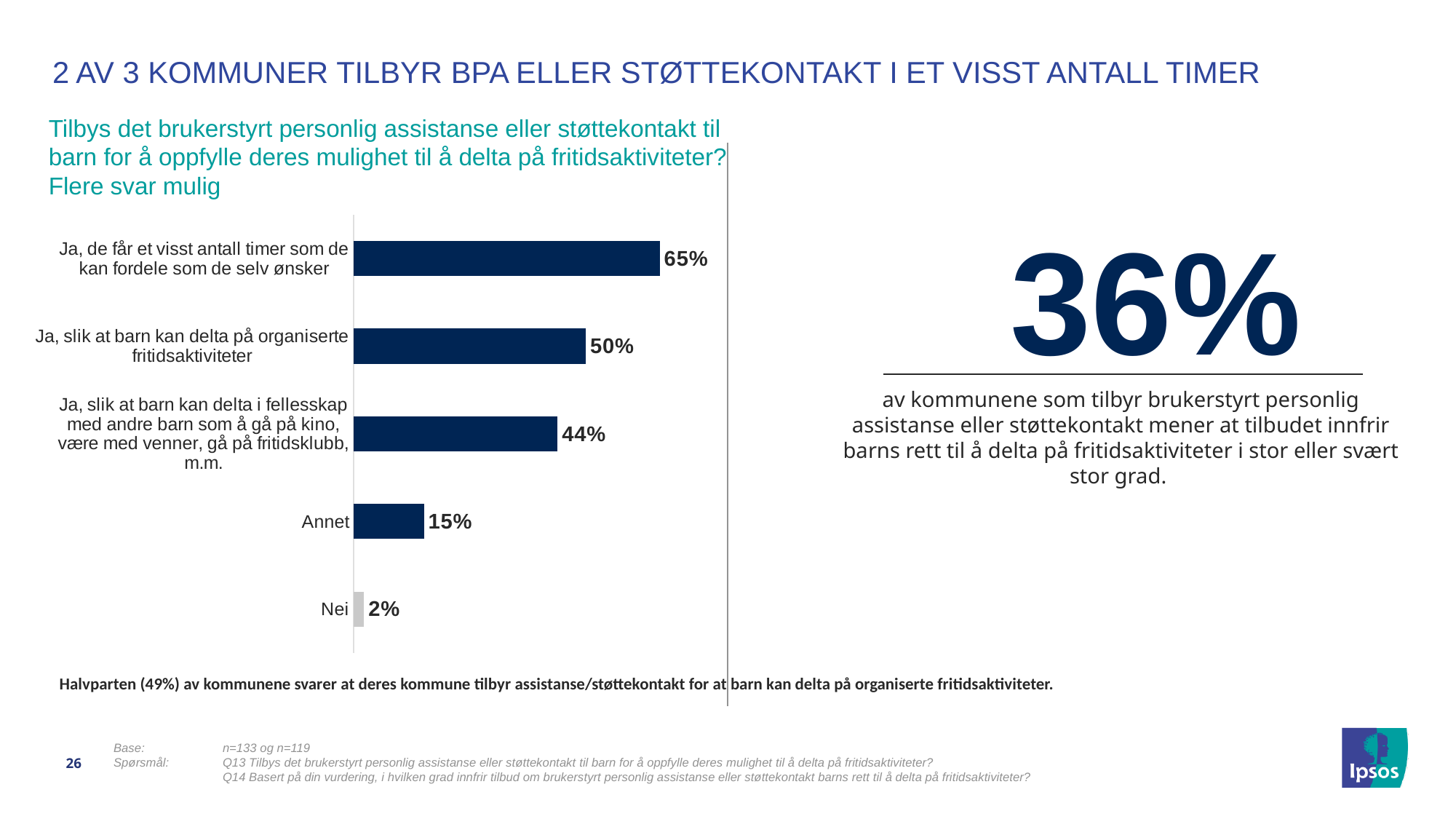
What is the value for "Nei"? 2% What is the value for "Annet"? 15% What is the value for "Ja, de får et visst antall timer som de kan fordele som de selv ønsker"? 65% What is the difference between the highest and lowest values in the chart? 63 percentage points Which category has the highest value? Ja, de får et visst antall timer som de kan fordele som de selv ønsker Which category has the lowest value? Nei What is the value for "Ja, slik at barn kan delta på organiserte fritidsaktiviteter"? 50% What is the difference between the values for "Ja, slik at barn kan delta på organiserte fritidsaktiviteter" and "Annet"? 35 percentage points Which is larger: the value for "Ja, slik at barn kan delta i fellesskap med andre barn som å gå på kino, være med venner, gå på fritidsklubb, m.m." or the value for "Annet"? Ja, slik at barn kan delta i fellesskap med andre barn som å gå på kino, være med venner, gå på fritidsklubb, m.m. How many categories are shown in the chart? 5 Which bar is shown in a different colour (grey) from the others? Nei What kind of chart is shown on the slide? Bar chart